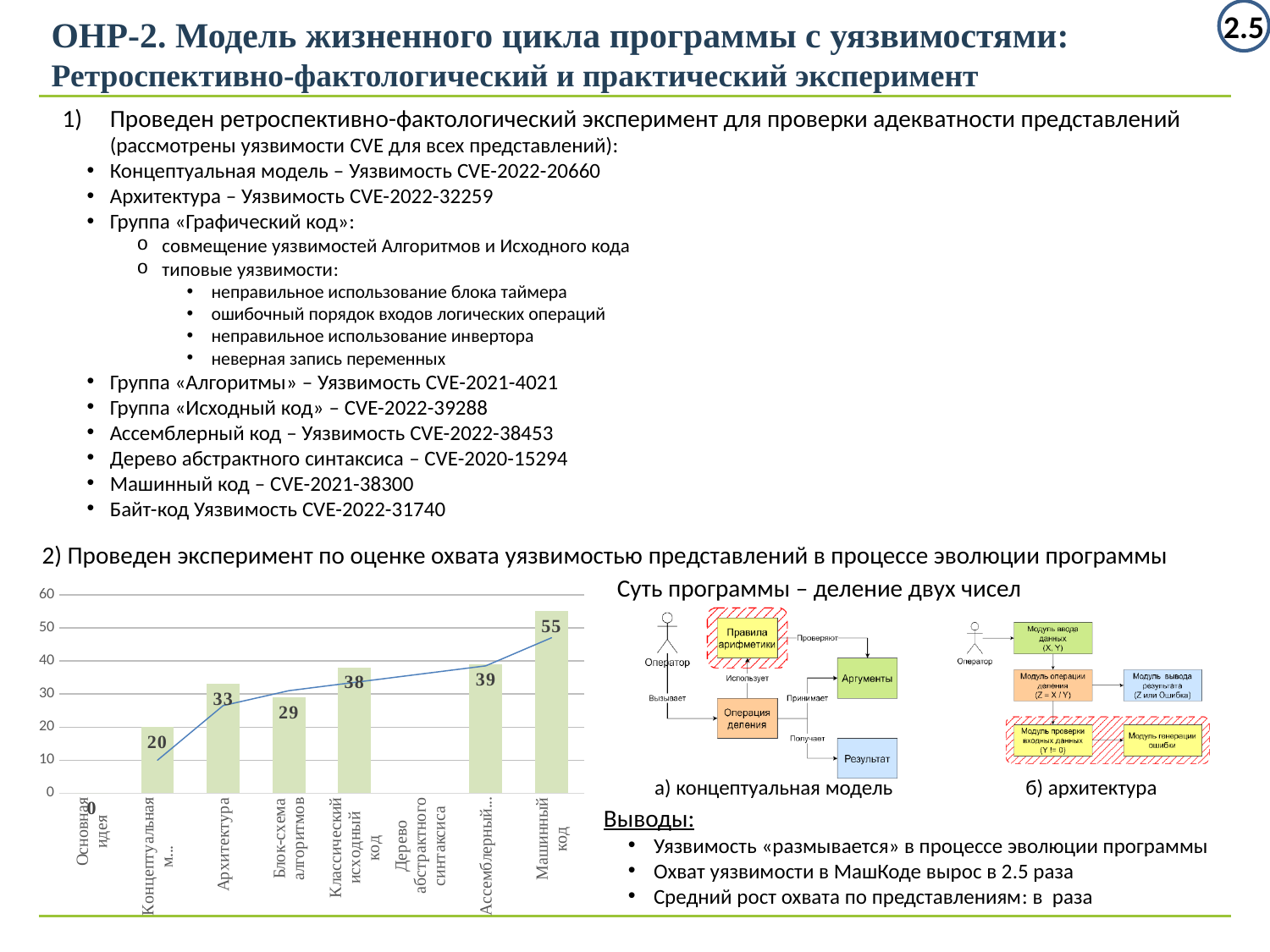
What is the difference between the values for Машинный код and Концептуальная модель in the bar chart? 35 What is the value for Блок-схема алгоритмов in the bar chart? 29 What is the value for Классический исходный код in the bar chart? 38 What is the difference between the values for Классический исходный код and Блок-схема алгоритмов? 9 Which category has the highest value in the bar chart? Машинный код Which is larger in the bar chart: the value for Архитектура or the value for Блок-схема алгоритмов? Архитектура What is the value for Машинный код in the bar chart? 55 What kind of chart is shown at the bottom left of the slide? bar chart What is the value for Архитектура in the bar chart? 33 What is the value for Основная идея in the bar chart? 0 Which category has the lowest value in the bar chart? Основная идея Is the value for Машинный код greater or less than 50? greater